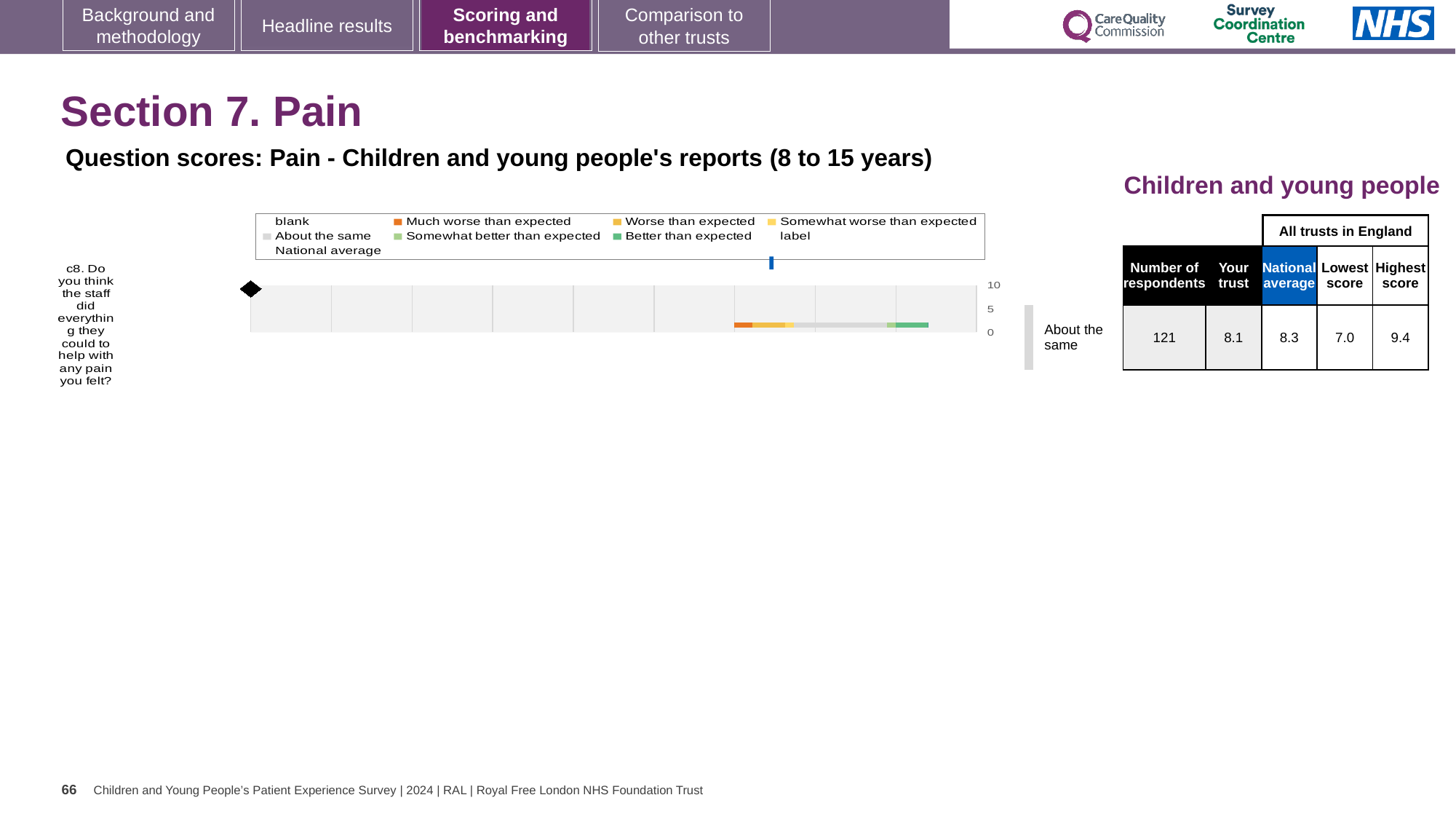
What is the highest score across all trusts in England for question c8? 9.4 What colour in the legend represents 'Much worse than expected'? Orange What is the lowest score across all trusts in England for question c8? 7.0 What is the national average score for question c8? 8.3 What kind of chart is used to show the c8 question score? bar chart What is the difference between the highest and lowest trust scores for question c8? 2.4 How many survey questions are plotted on the chart? 1 What is the 'Your trust' score for question c8 about staff helping with pain? 8.1 What benchmark category is the trust's result for question c8 placed in? About the same Which is larger for question c8: the 'Your trust' score or the national average? National average Is the 'Your trust' score for question c8 greater or less than 5? greater How many respondents answered question c8? 121